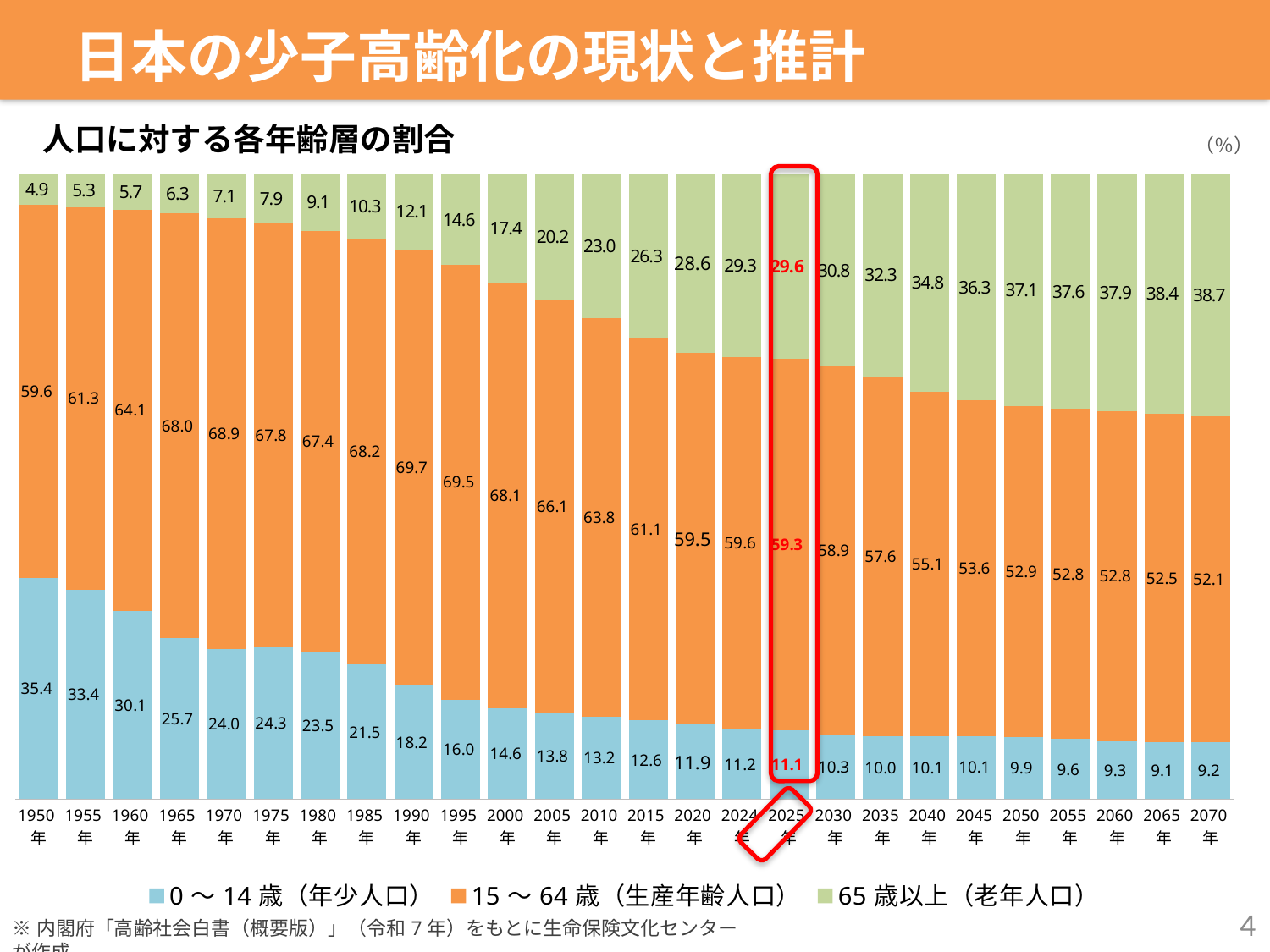
In which year is the 65歳以上（老年人口） share highest? 2070年 What type of chart is shown on the slide? Stacked bar chart What is the value for 0～14歳（年少人口） in 1950年? 35.4 What is the difference between the 65歳以上 share in 2070年 and in 1950年? 33.8 Which is larger in 2024年: the 0～14歳 share or the 65歳以上 share? 65歳以上 (29.3) How many years (categories) are shown on the x axis? 26 In which year is the 15～64歳（生産年齢人口） share highest? 1990年 Does the 0～14歳（年少人口） share rise or fall from 1950年 to 2070年? Fall How many series does the legend list? 3 What is the value for 65歳以上（老年人口） in 2025年? 29.6 What is the value for 15～64歳（生産年齢人口） in 2070年? 52.1 Which year is highlighted with a red box on the chart? 2025年